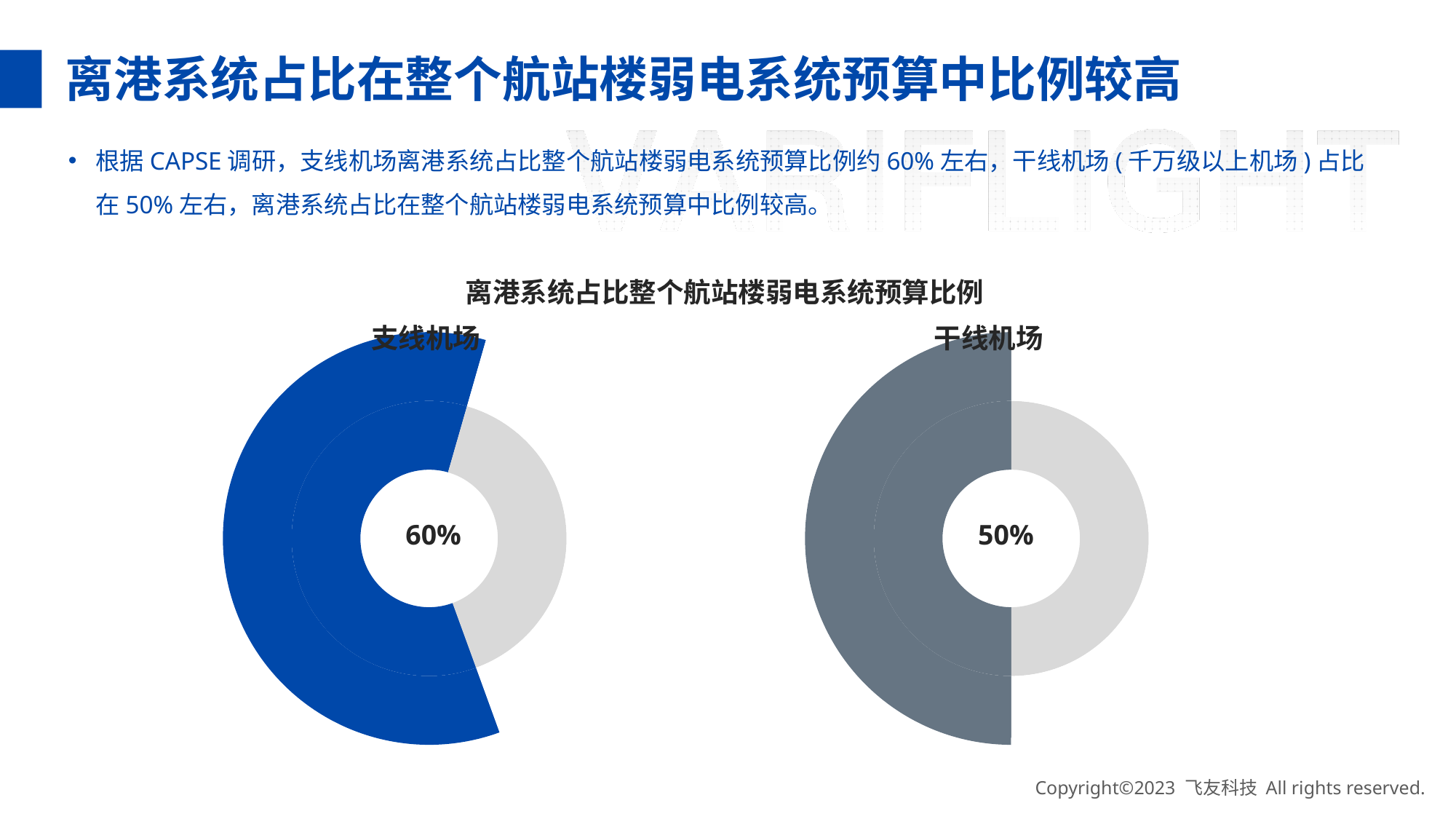
In the 支线机场 donut chart, is the highlighted share greater or less than 50%? greater What is the title printed above the two donut charts? 离港系统占比整个航站楼弱电系统预算比例 What colour is the highlighted segment in the 支线机场 donut chart? Blue What kind of chart is used for 支线机场 on the left of the slide? Donut (pie) chart Which chart is on the right side of the slide, 支线机场 or 干线机场? 干线机场 Comparing the two donut charts, which airport type has the lower share? 干线机场 How many donut charts are shown on the slide? 2 In the 干线机场 donut chart, what percentage is shown in the centre? 50% In the 支线机场 donut chart, what percentage is shown in the centre? 60% What is the difference between the percentage shown for 支线机场 and the percentage shown for 干线机场? 10% In the 干线机场 donut chart, what share of the whole does the highlighted grey segment represent? 50% Comparing the two donut charts, which airport type has the higher share: 支线机场 or 干线机场? 支线机场